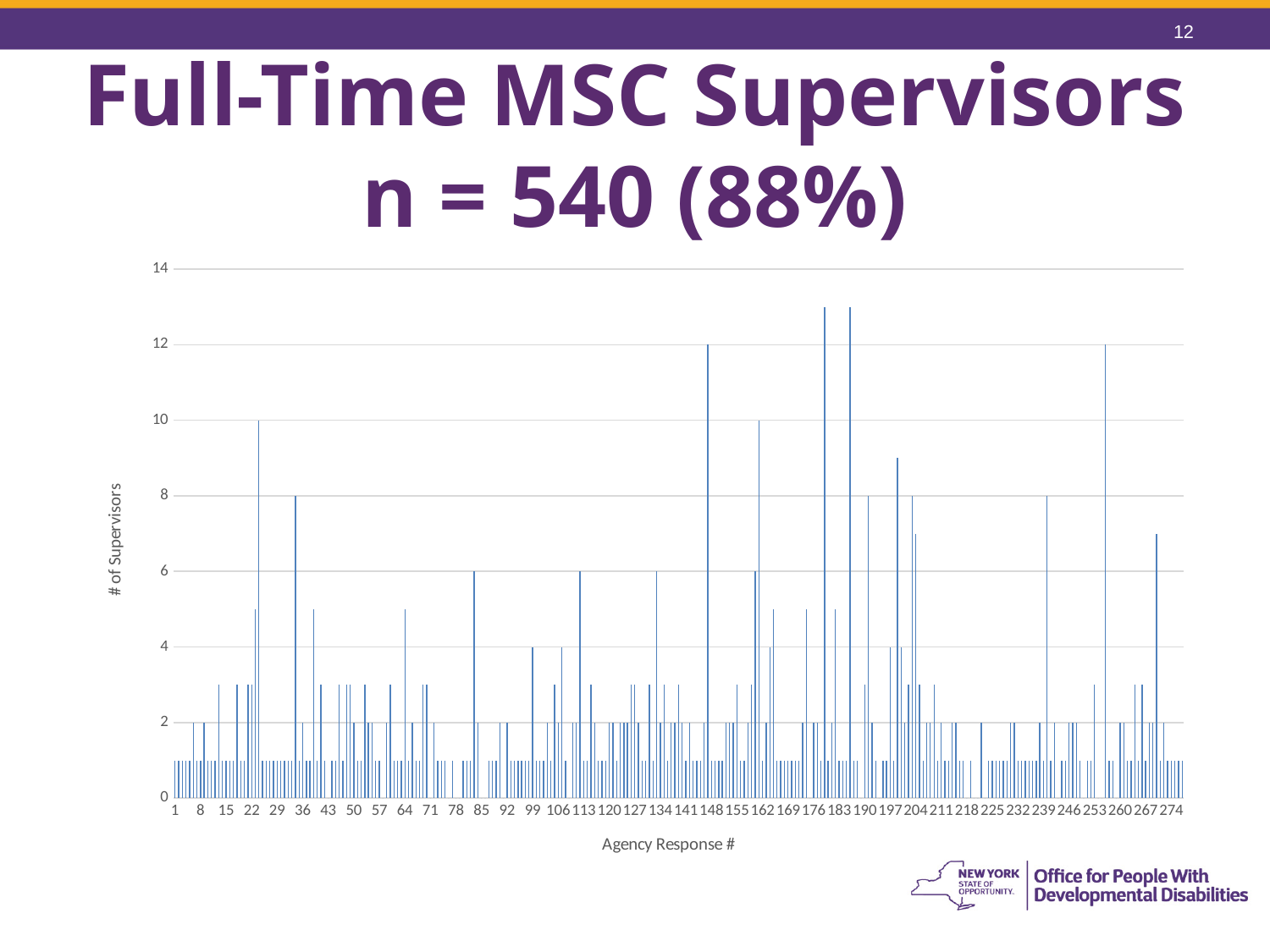
Is the tallest bar in the chart greater or less than 14? less Is the tallest bar in the chart greater or less than 12? greater What is the title of the chart on the slide? Full-Time MSC Supervisors n = 540 (88%) Is the value for Agency Response #1 greater or less than 2? less What is the label of the vertical axis? # of Supervisors What is the last tick label shown on the horizontal axis? 274 What kind of chart is shown on the slide? bar chart What is the highest value shown on the vertical axis? 14